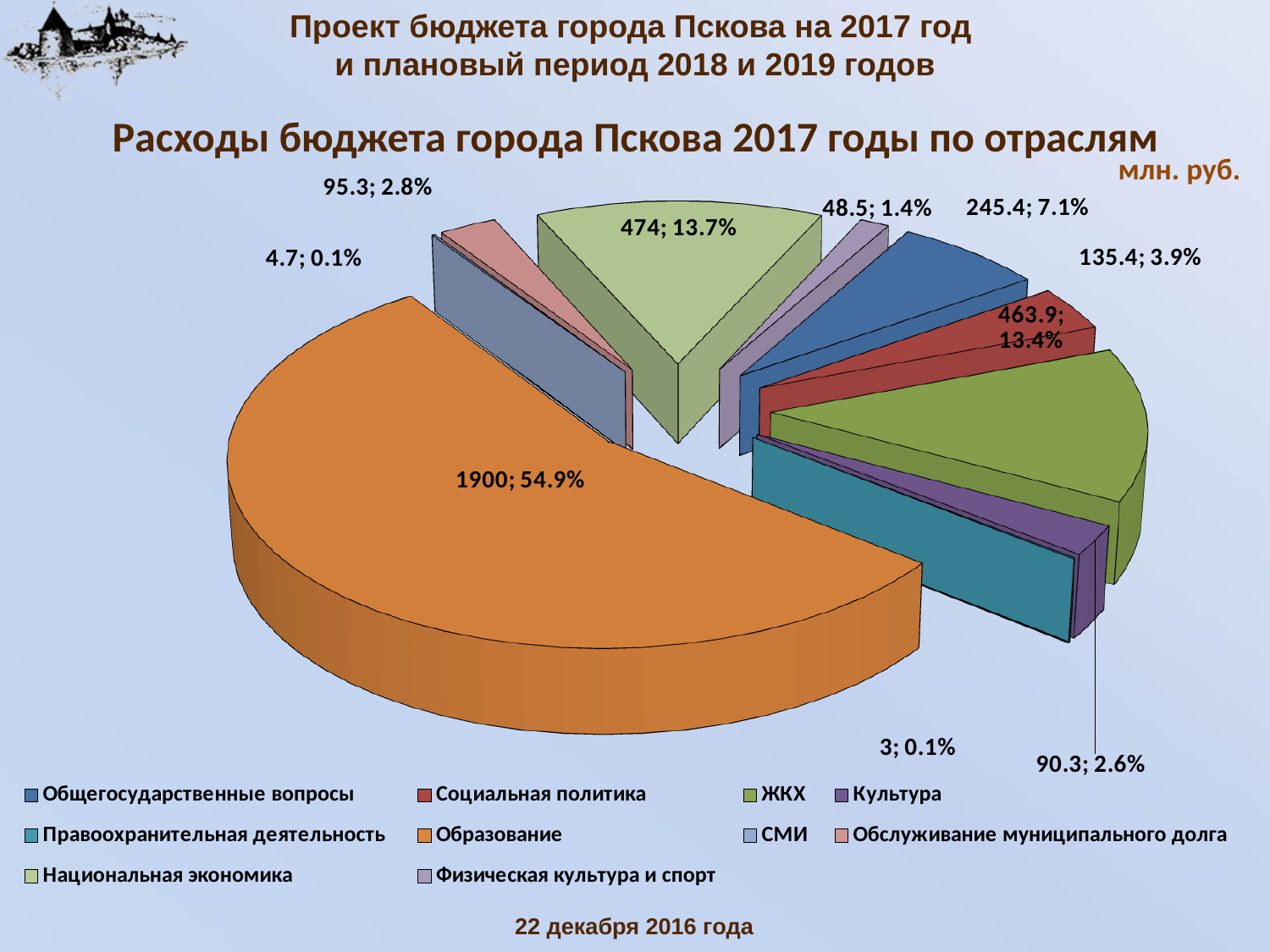
What is the difference between the value for Образование and the value for Национальная экономика? 1426 What share of the pie does Образование account for? 54.9% What kind of chart is shown on the slide? pie chart What is the value for Образование in the pie chart? 1900 Which is larger, the value for Национальная экономика or the value for ЖКХ? Национальная экономика What is the value for Общегосударственные вопросы in the pie chart? 245.4 How many categories does the legend of the pie chart list? 10 In what unit are the values of the pie chart given, according to the slide? млн. руб. What is the value for Национальная экономика in the pie chart? 474 What share of the pie does ЖКХ account for? 13.4% What share of the pie does Физическая культура и спорт account for? 1.4% Which category has the largest slice in the pie chart? Образование